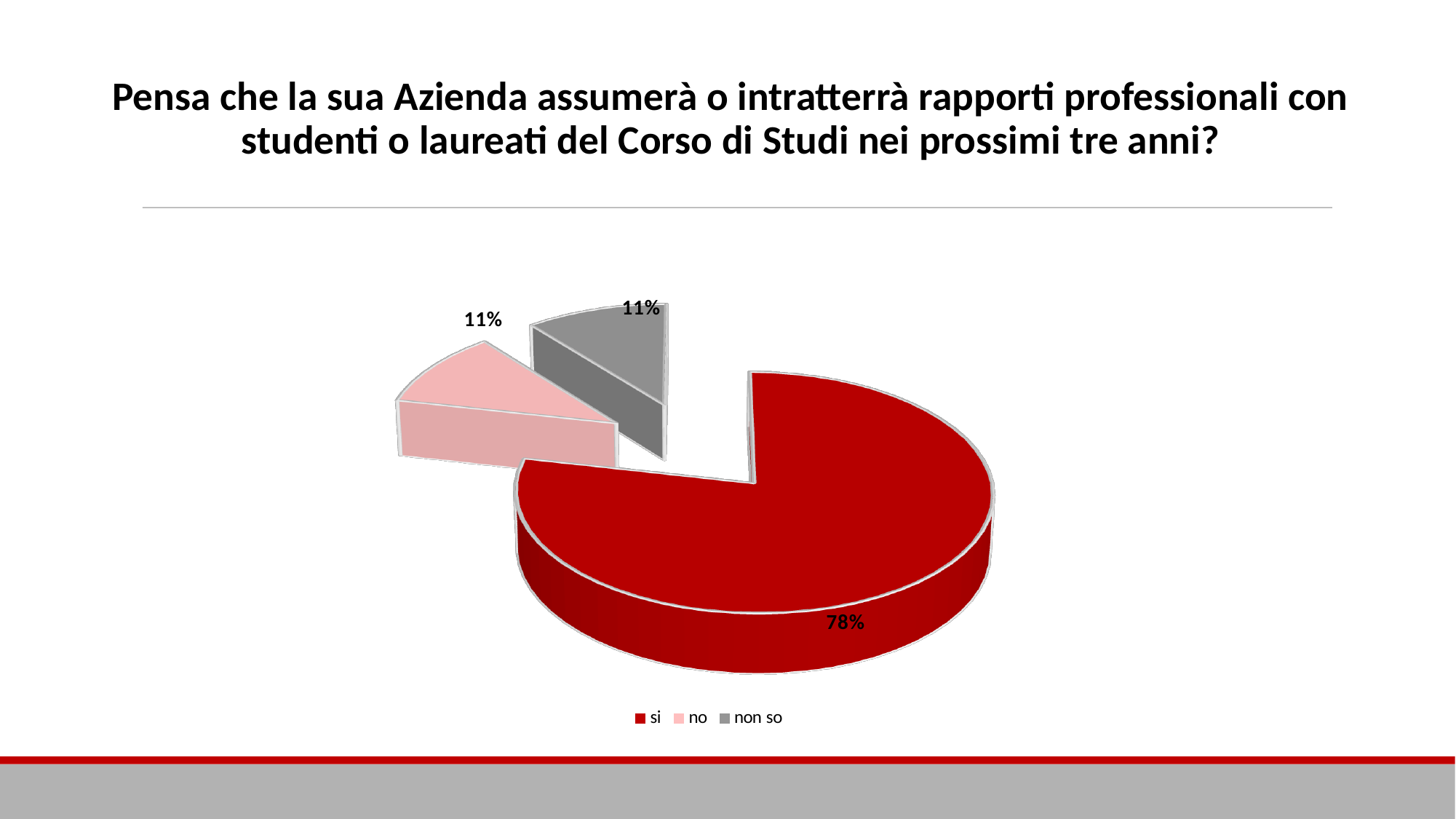
What colour is the "si" slice? red How many entries does the legend list? 3 Which category has the largest slice of the pie? si What is the difference in percentage points between the "si" slice and the "no" slice? 67 How many slices does the pie chart have? 3 What kind of chart is shown on the slide? pie chart Which is larger, the "si" slice or the "non so" slice? si What share of the pie does the "non so" slice represent? 11% What share of the pie does the "no" slice represent? 11% Which legend entry is shown in grey? non so What share of the pie does the "si" slice represent? 78%